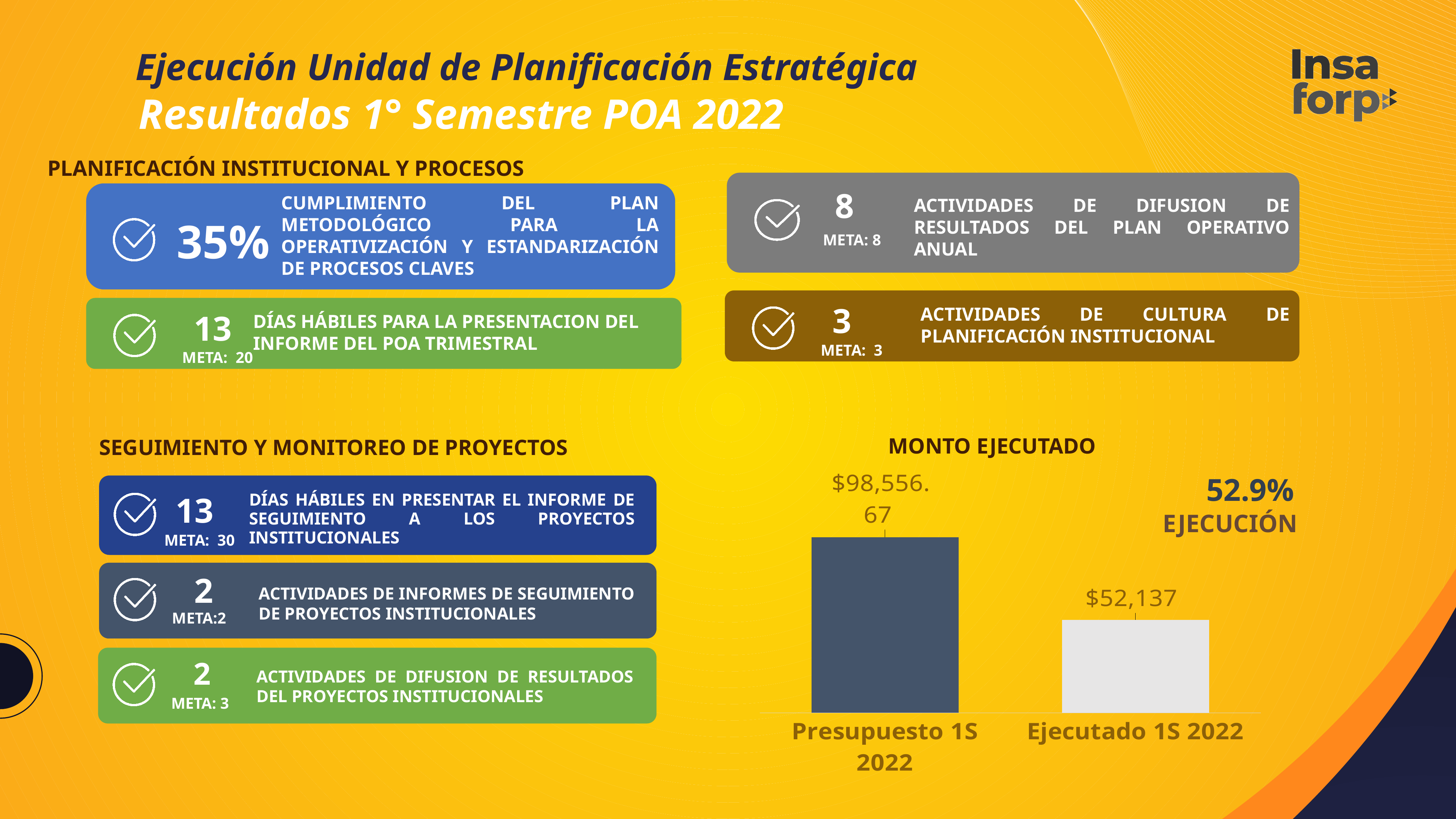
Which category has the highest value in the MONTO EJECUTADO chart? Presupuesto 1S 2022 What execution percentage is shown next to the MONTO EJECUTADO chart? 52.9% What is the value of the Presupuesto 1S 2022 bar in the MONTO EJECUTADO chart? $98,556.67 Which category has the lowest value in the MONTO EJECUTADO chart? Ejecutado 1S 2022 What is the title of the chart on the slide? MONTO EJECUTADO What is the difference between the Presupuesto 1S 2022 and Ejecutado 1S 2022 values in the MONTO EJECUTADO chart? $46,419.67 What is the value of the Ejecutado 1S 2022 bar in the MONTO EJECUTADO chart? $52,137 What kind of chart is the MONTO EJECUTADO chart? Bar chart How many bars are shown in the MONTO EJECUTADO chart? 2 Do the values in the MONTO EJECUTADO chart rise or fall from left to right? Fall In the MONTO EJECUTADO chart, which is larger: Presupuesto 1S 2022 or Ejecutado 1S 2022? Presupuesto 1S 2022